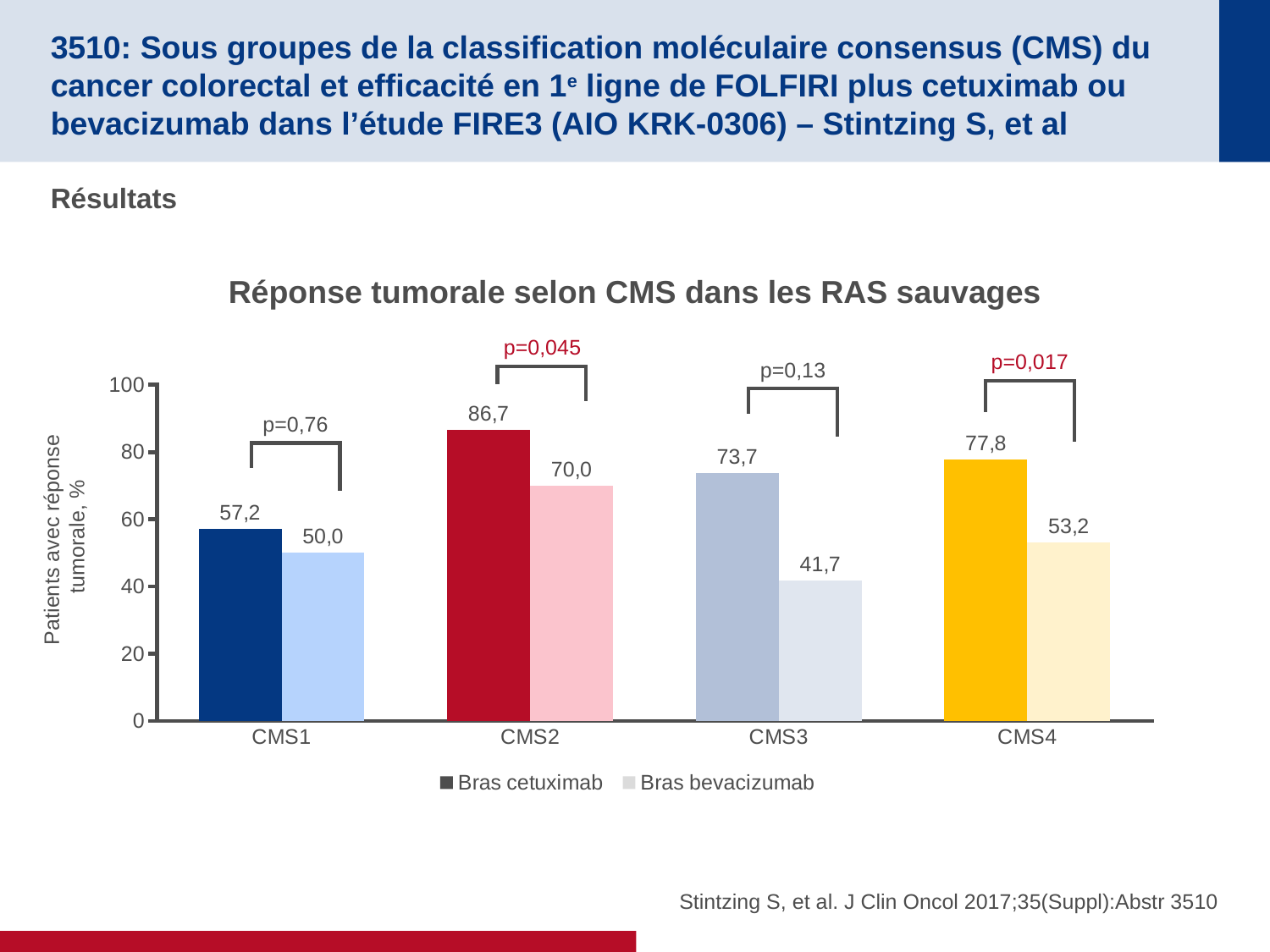
Which is larger in CMS1: Bras cetuximab or Bras bevacizumab? Bras cetuximab What is the title of the chart? Réponse tumorale selon CMS dans les RAS sauvages What is the value for Bras bevacizumab in CMS4? 53,2 How many series does the legend list? 2 Is the value for Bras bevacizumab in CMS2 greater or less than 60? greater Which CMS subgroup has the highest value for Bras cetuximab? CMS2 What is the value for Bras cetuximab in CMS2? 86,7 What is the difference between Bras cetuximab and Bras bevacizumab in CMS3? 32,0 Which CMS subgroup has the lowest value for Bras bevacizumab? CMS3 How many CMS subgroups are shown on the x axis? 4 What is the value for Bras bevacizumab in CMS3? 41,7 What kind of chart is shown? Bar chart